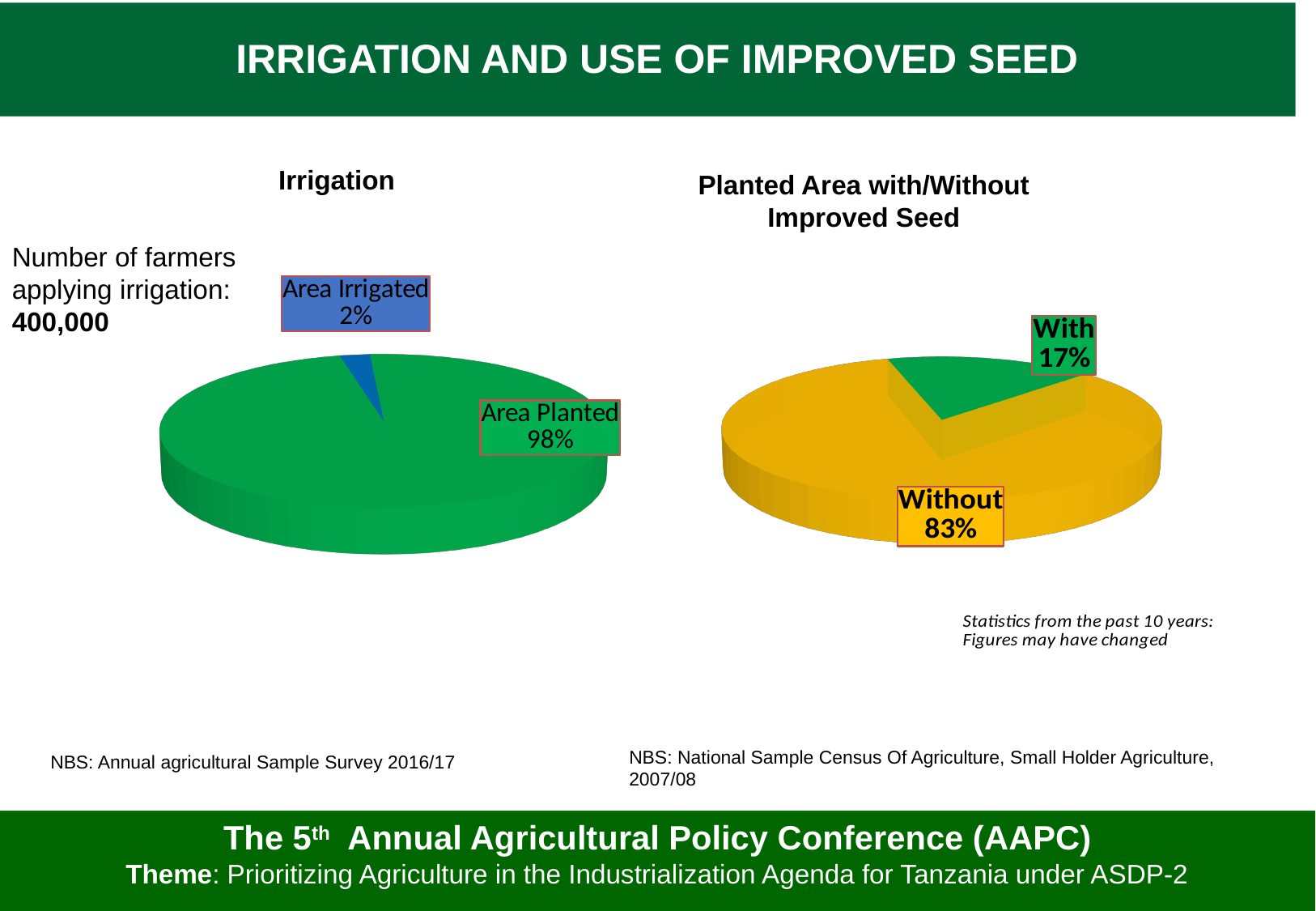
How many slices does the Planted Area with/Without Improved Seed chart have? 2 In the Planted Area with/Without Improved Seed chart, which is larger, With or Without? Without In the Irrigation chart, what is the difference between the Area Planted and Area Irrigated shares? 96% In the Planted Area with/Without Improved Seed chart, what share of the pie is With? 17% In the Irrigation chart, which slice is the largest? Area Planted What kind of chart is the Irrigation chart? Pie chart In the Planted Area with/Without Improved Seed chart, what is the difference between the Without and With shares? 66% In the Irrigation chart, what share of the pie is Area Irrigated? 2% In the Planted Area with/Without Improved Seed chart, which slice is the smallest? With In the Planted Area with/Without Improved Seed chart, what colour is the Without slice? Yellow In the Planted Area with/Without Improved Seed chart, what share of the pie is Without? 83%